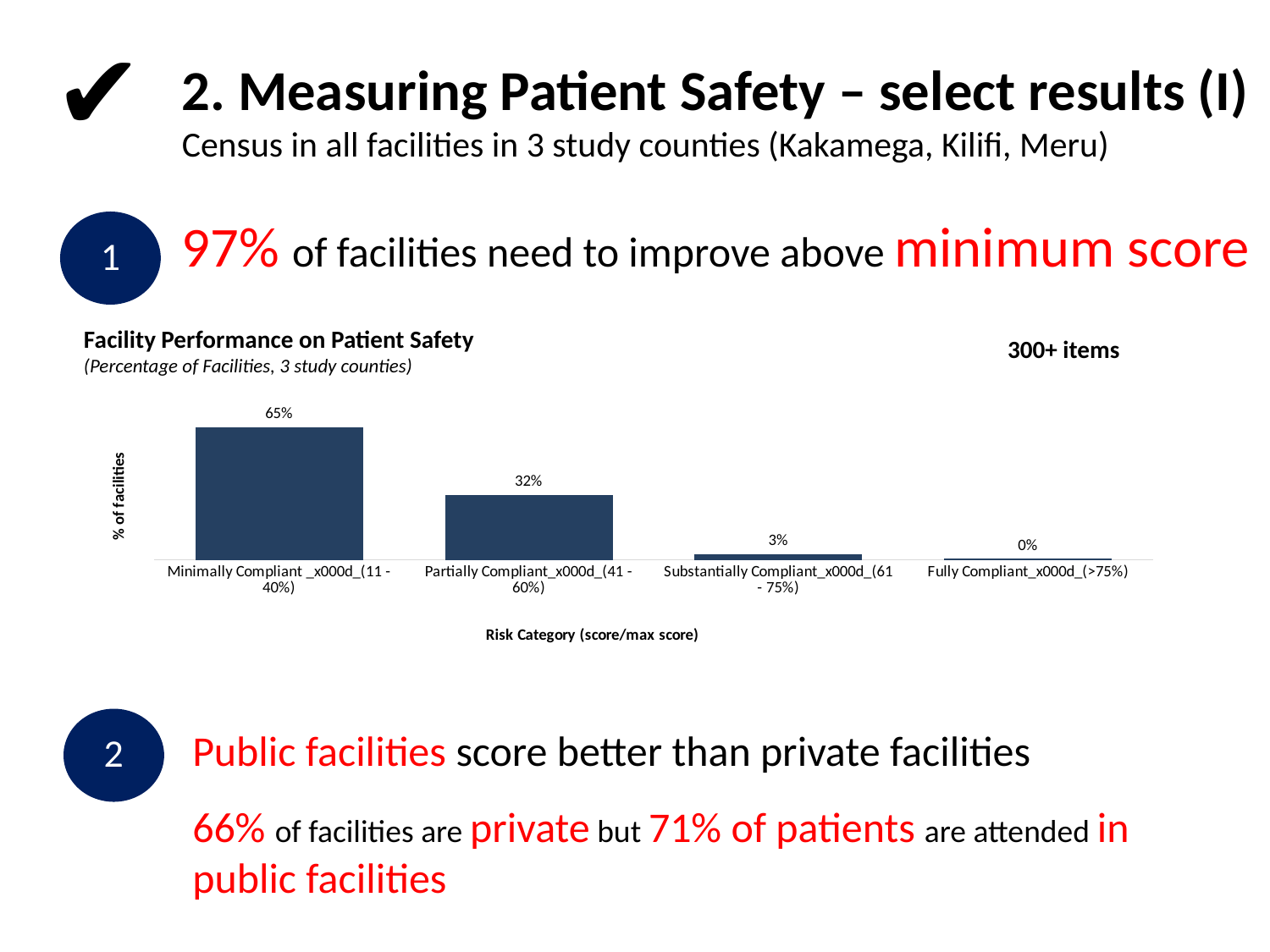
Do the values rise or fall moving from left to right along the x axis? Fall Which risk category has the highest percentage of facilities? Minimally Compliant (11 - 40%) What is the difference in percentage points between Minimally Compliant and Partially Compliant facilities? 33 What type of chart is used to show Facility Performance on Patient Safety? Bar chart What percentage of facilities are Minimally Compliant (11 - 40%)? 65% Which risk category has the lowest percentage of facilities? Fully Compliant (>75%) What percentage of facilities are Substantially Compliant (61 - 75%)? 3% What is the title of the chart? Facility Performance on Patient Safety Which is larger: the percentage of Partially Compliant facilities or Substantially Compliant facilities? Partially Compliant What percentage of facilities are Partially Compliant (41 - 60%)? 32% How many risk categories are shown on the x axis of the chart? 4 What percentage of facilities are Fully Compliant (>75%)? 0%